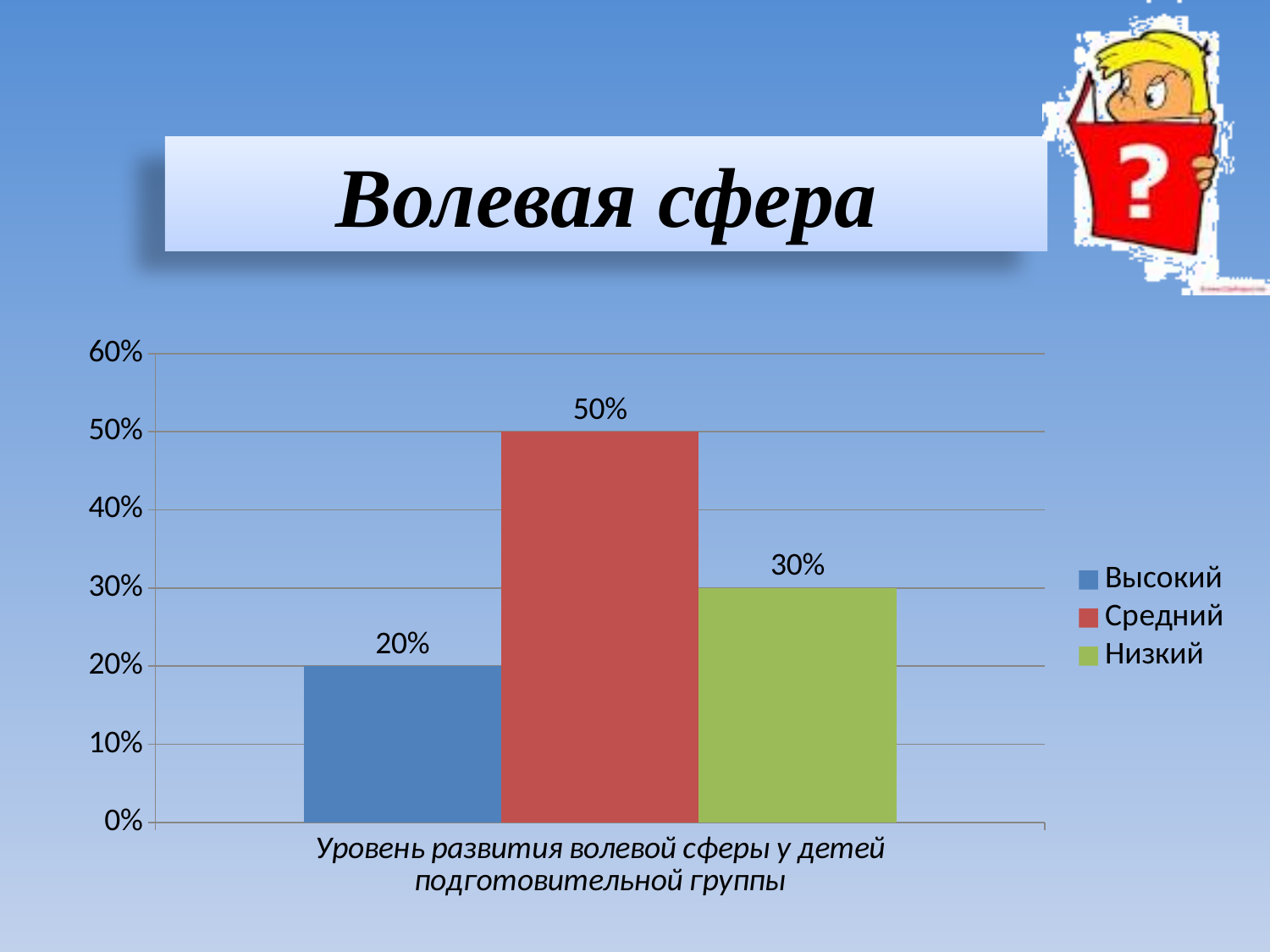
What is the difference between the values for Средний and Низкий? 20% What is the value for Средний? 50% Which series has the lowest value? Высокий Which is larger, the value for Высокий or the value for Низкий? Низкий What is the value for Низкий? 30% What is the value for Высокий? 20% What is the difference between the values for Низкий and Высокий? 10% Is the value for Средний greater or less than 40%? greater What kind of chart is shown on the slide? bar chart How many series does the legend list? 3 What colour is the bar for Средний? red Which series has the highest value? Средний